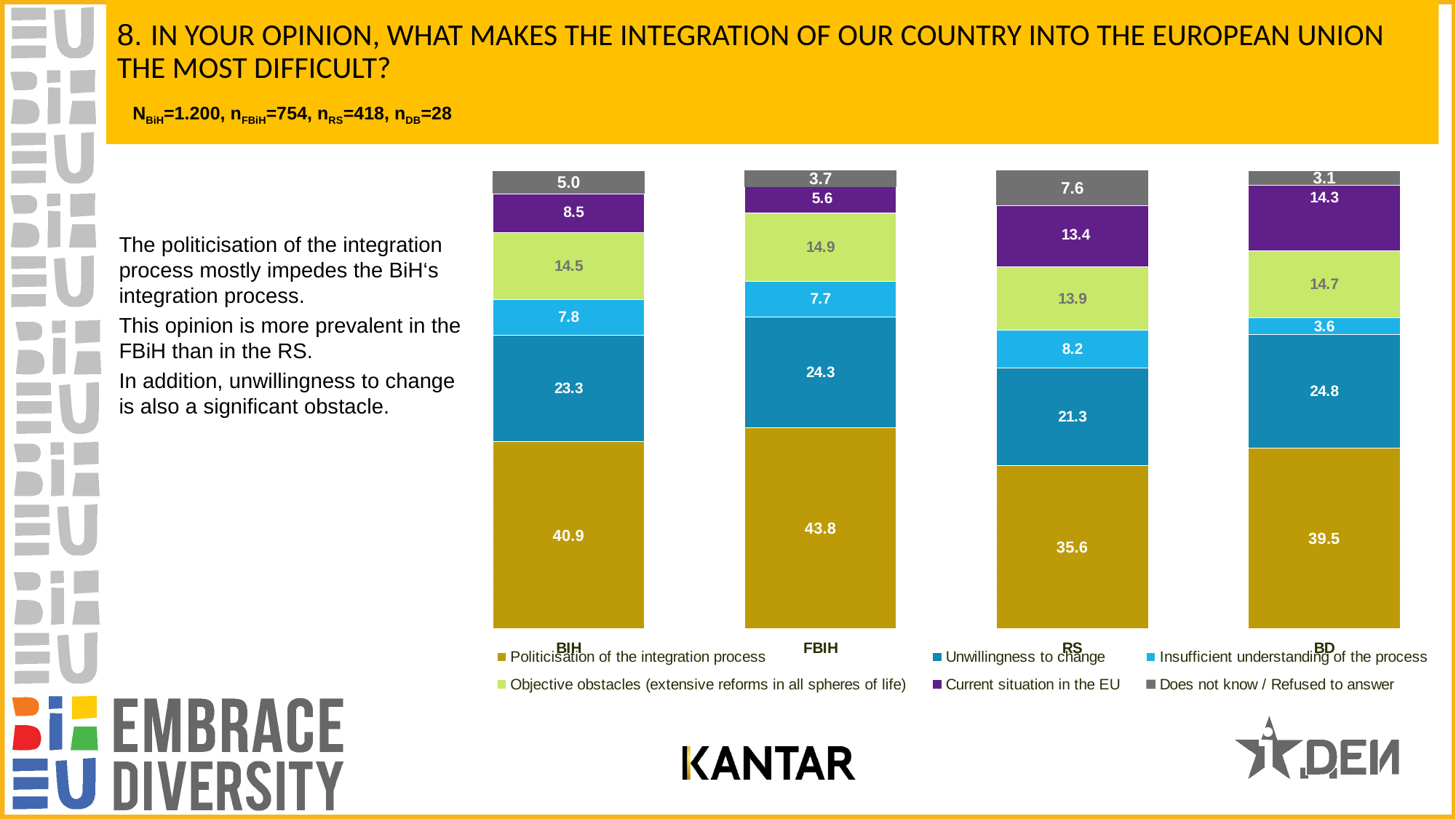
How many series does the legend list? 6 What is the value for 'Current situation in the EU' in the BD bar? 14.3 What kind of chart is shown on the slide? Stacked bar chart What is the value for 'Unwillingness to change' in the RS bar? 21.3 What is the difference between the 'Politicisation of the integration process' values for FBIH and RS? 8.2 What is the value for 'Politicisation of the integration process' in the FBIH bar? 43.8 Which is larger: the 'Current situation in the EU' value for RS or for FBIH? RS How many categories are shown on the x axis? 4 What is the total of the stacked bar for BD? 100.0 Which category has the highest value for 'Politicisation of the integration process'? FBIH Which category has the lowest value for 'Insufficient understanding of the process'? BD What is the value for 'Does not know / Refused to answer' in the BIH bar? 5.0